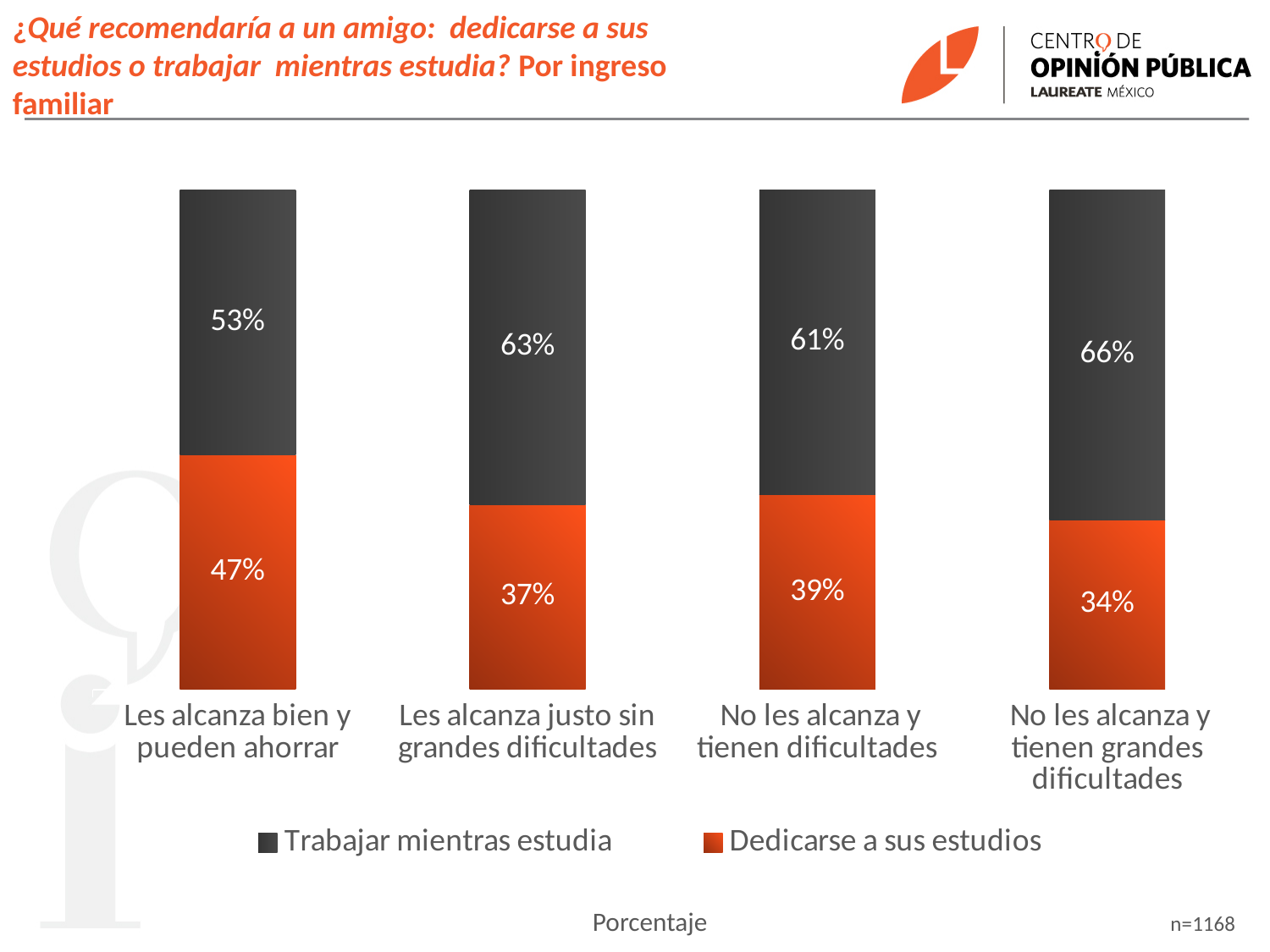
Which is larger: 'Dedicarse a sus estudios' for 'Les alcanza justo sin grandes dificultades' or for 'No les alcanza y tienen dificultades'? No les alcanza y tienen dificultades Which income category has the highest value for 'Trabajar mientras estudia'? No les alcanza y tienen grandes dificultades What kind of chart is shown on the slide? Stacked bar chart How many series does the legend list? 2 What is the difference between the 'Trabajar mientras estudia' values for 'No les alcanza y tienen grandes dificultades' and 'Les alcanza bien y pueden ahorrar'? 13 percentage points What is the total of the stacked bar for 'Les alcanza justo sin grandes dificultades'? 100% Which income category has the highest value for 'Dedicarse a sus estudios'? Les alcanza bien y pueden ahorrar What percentage of respondents in the 'Les alcanza bien y pueden ahorrar' group recommend 'Trabajar mientras estudia'? 53% How many income categories are shown on the x axis? 4 Which income category has the lowest value for 'Dedicarse a sus estudios'? No les alcanza y tienen grandes dificultades What is the value for 'Dedicarse a sus estudios' in the 'No les alcanza y tienen dificultades' category? 39% What percentage of respondents in the 'No les alcanza y tienen grandes dificultades' group recommend 'Dedicarse a sus estudios'? 34%